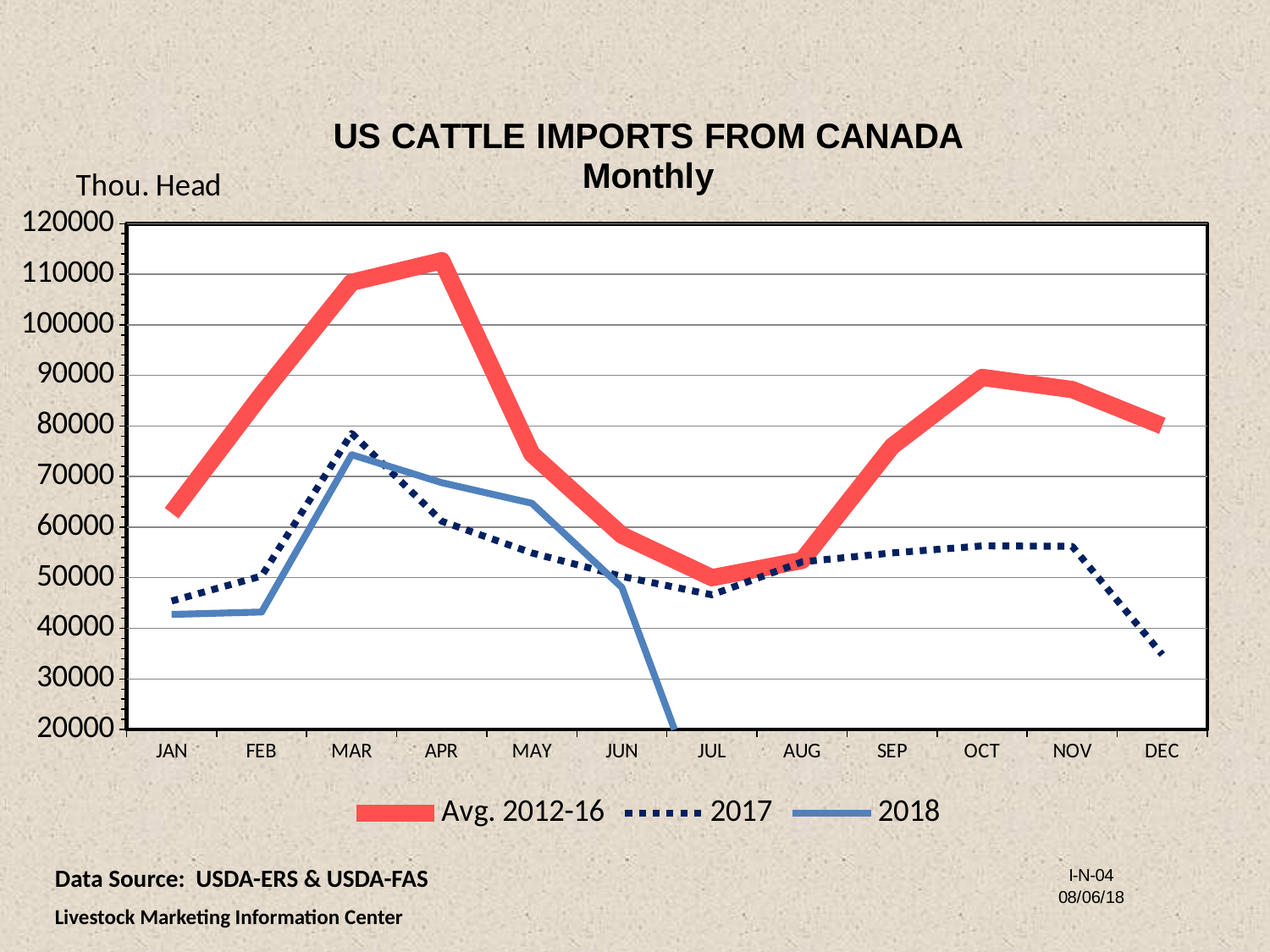
In which month is the 2017 series at its lowest? DEC Does the Avg. 2012-16 series rise or fall from APR to JUL? fall In APR, which series is higher: 2017 or 2018? 2018 What kind of chart is shown on the slide? line chart How many months are shown along the x axis? 12 Is the Avg. 2012-16 value for APR greater or less than 100000? greater In which month is the Avg. 2012-16 series at its lowest? JUL Is the 2017 value for DEC greater or less than 40000? less Is the 2018 value for JAN greater or less than 50000? less In which month does the Avg. 2012-16 series reach its highest value? APR How many series does the legend list? 3 In which month does the 2017 series reach its highest value? MAR